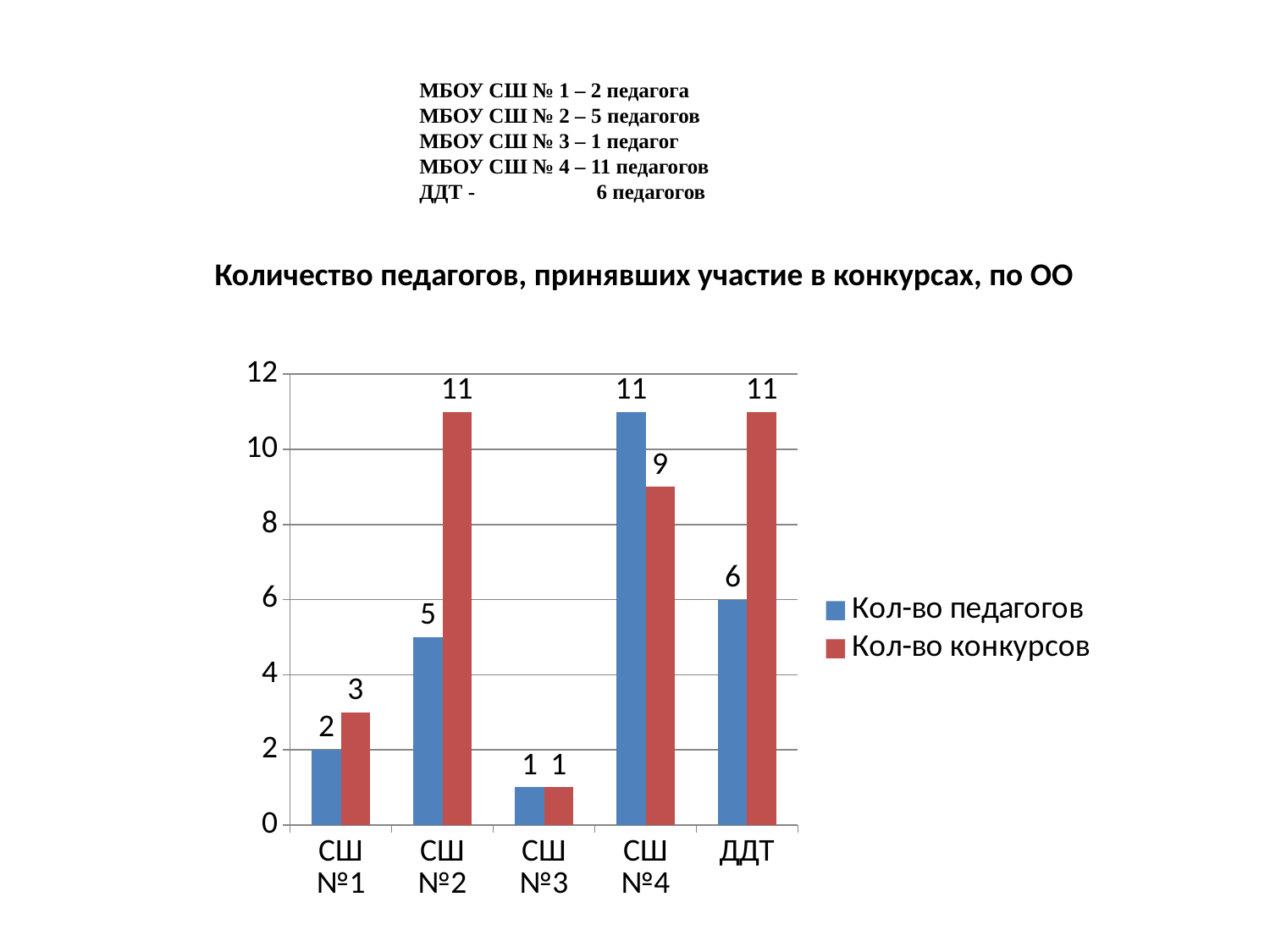
What is the difference between Кол-во конкурсов and Кол-во педагогов for ДДТ? 5 What is the value of Кол-во конкурсов for СШ №1? 3 What is the value of Кол-во конкурсов for СШ №4? 9 What is the value of Кол-во педагогов for СШ №2? 5 What is the title of the chart? Количество педагогов, принявших участие в конкурсах, по ОО Is the value of Кол-во конкурсов for СШ №2 greater or less than 8? greater How many series does the legend list? 2 Which category has the highest value for Кол-во педагогов? СШ №4 Which is larger for СШ №4: Кол-во педагогов or Кол-во конкурсов? Кол-во педагогов Which category has the lowest value for Кол-во конкурсов? СШ №3 What kind of chart is shown? bar chart How many categories are shown on the x axis? 5